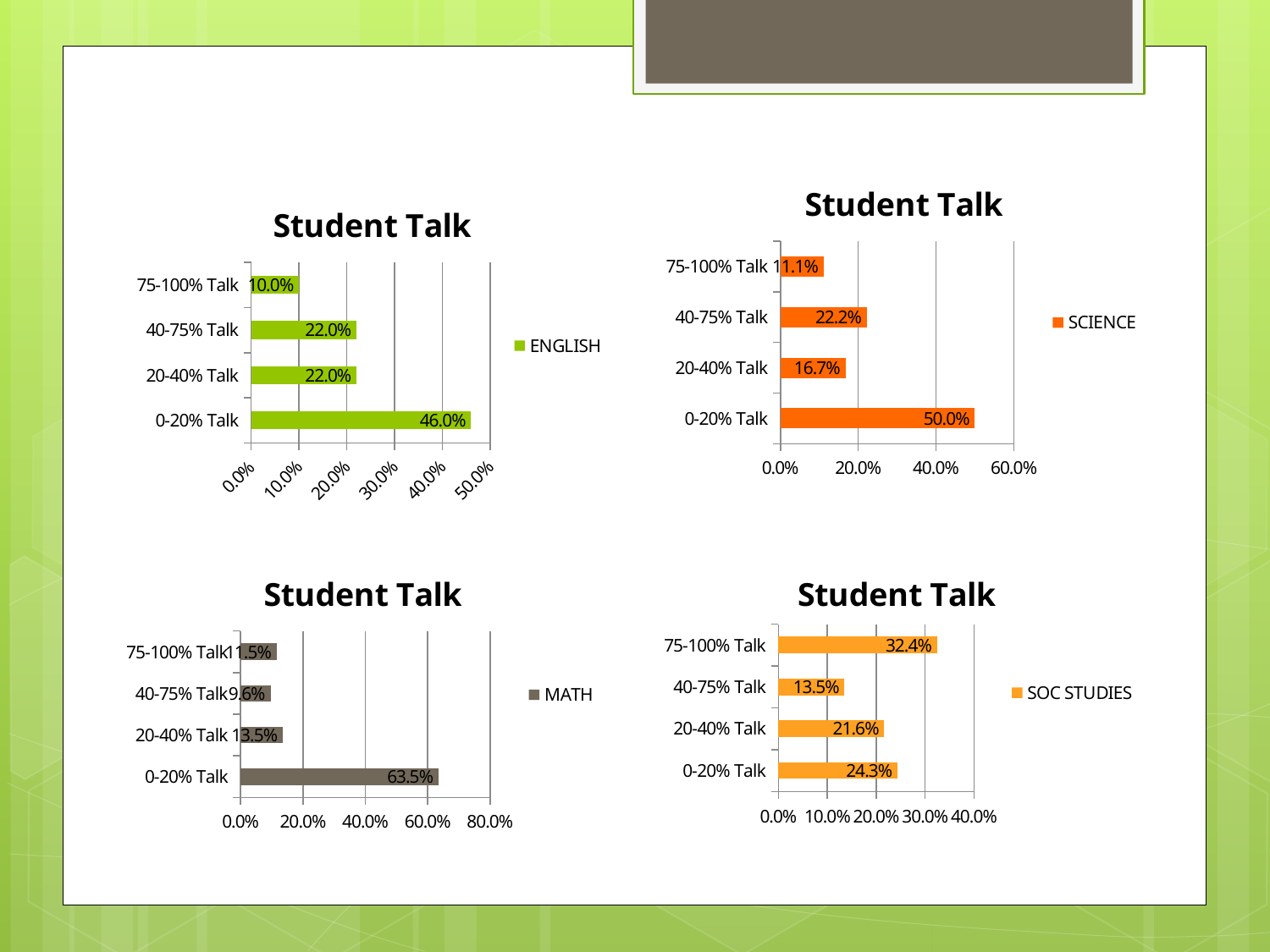
How many series does the legend of the bottom-right chart list? 1 In the top-left chart (ENGLISH), which is larger: the value for 0-20% Talk or the value for 75-100% Talk? 0-20% Talk In the bottom-right chart (SOC STUDIES), what is the value for 75-100% Talk? 32.4% What kind of chart is the top-right chart (SCIENCE)? Bar chart How many categories are shown in the bottom-left chart (MATH)? 4 In the bottom-left chart (MATH), which category has the highest value? 0-20% Talk In the top-left chart (ENGLISH), what is the value for 0-20% Talk? 46.0% In the top-right chart (SCIENCE), what is the difference between the values for 0-20% Talk and 40-75% Talk? 27.8% In the top-right chart (SCIENCE), what is the value for 20-40% Talk? 16.7% In the bottom-left chart (MATH), what is the value for 0-20% Talk? 63.5% In the bottom-right chart (SOC STUDIES), which category has the lowest value? 40-75% Talk What is the legend entry of the top-left chart? ENGLISH